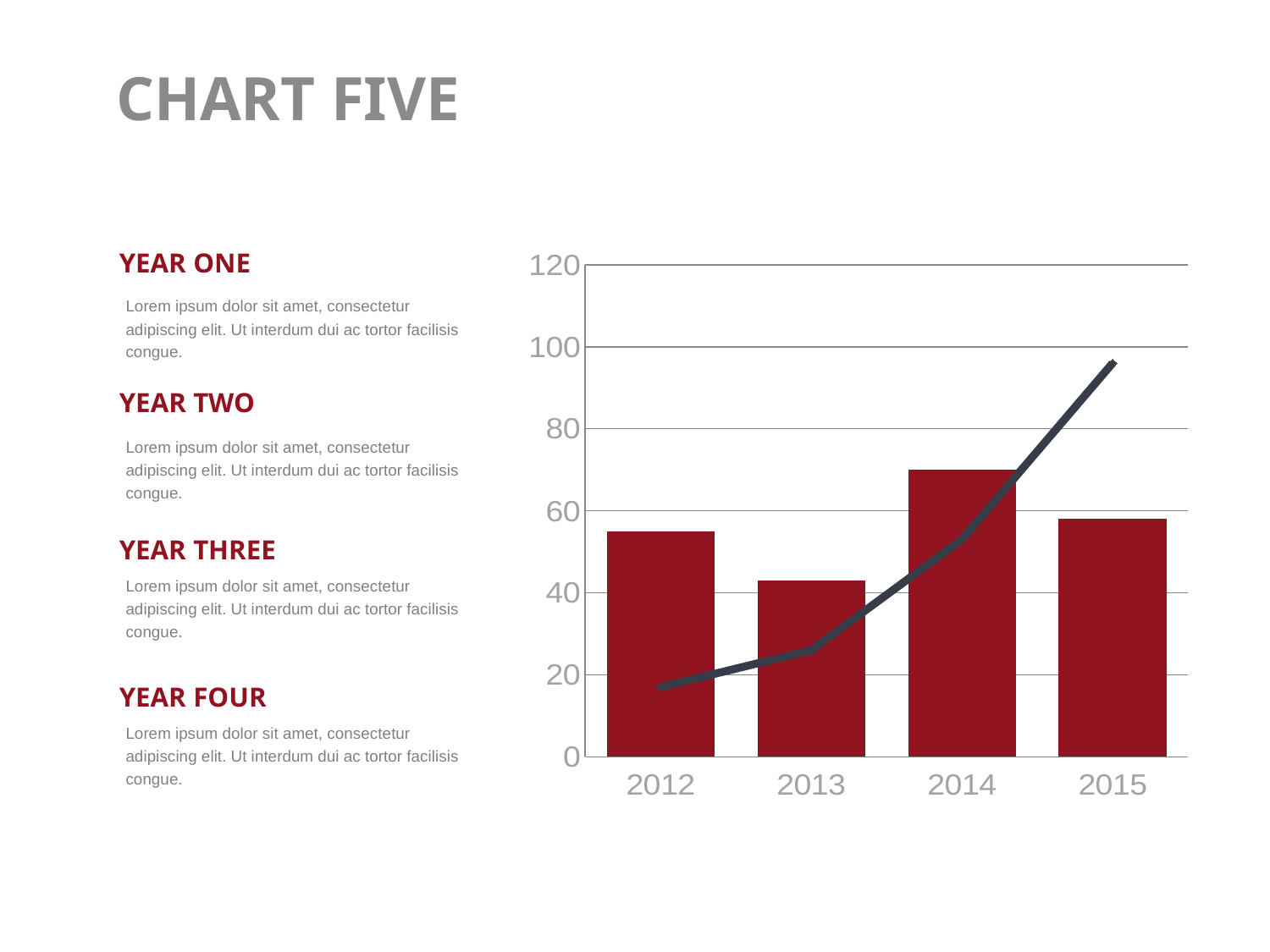
What kind of chart is shown on the slide? bar chart with a line What is the title of the slide containing the chart? CHART FIVE Is the bar value for 2015 greater or less than 80? less Which year has the tallest bar? 2014 Which bar is taller, 2013 or 2014? 2014 Is the line value for 2015 greater or less than 80? greater Is the bar value for 2014 greater or less than 60? greater Does the line series rise or fall from 2012 to 2015? rise How many years are shown on the x axis of the chart? 4 Which year has the shortest bar? 2013 Which bar is taller, 2012 or 2013? 2012